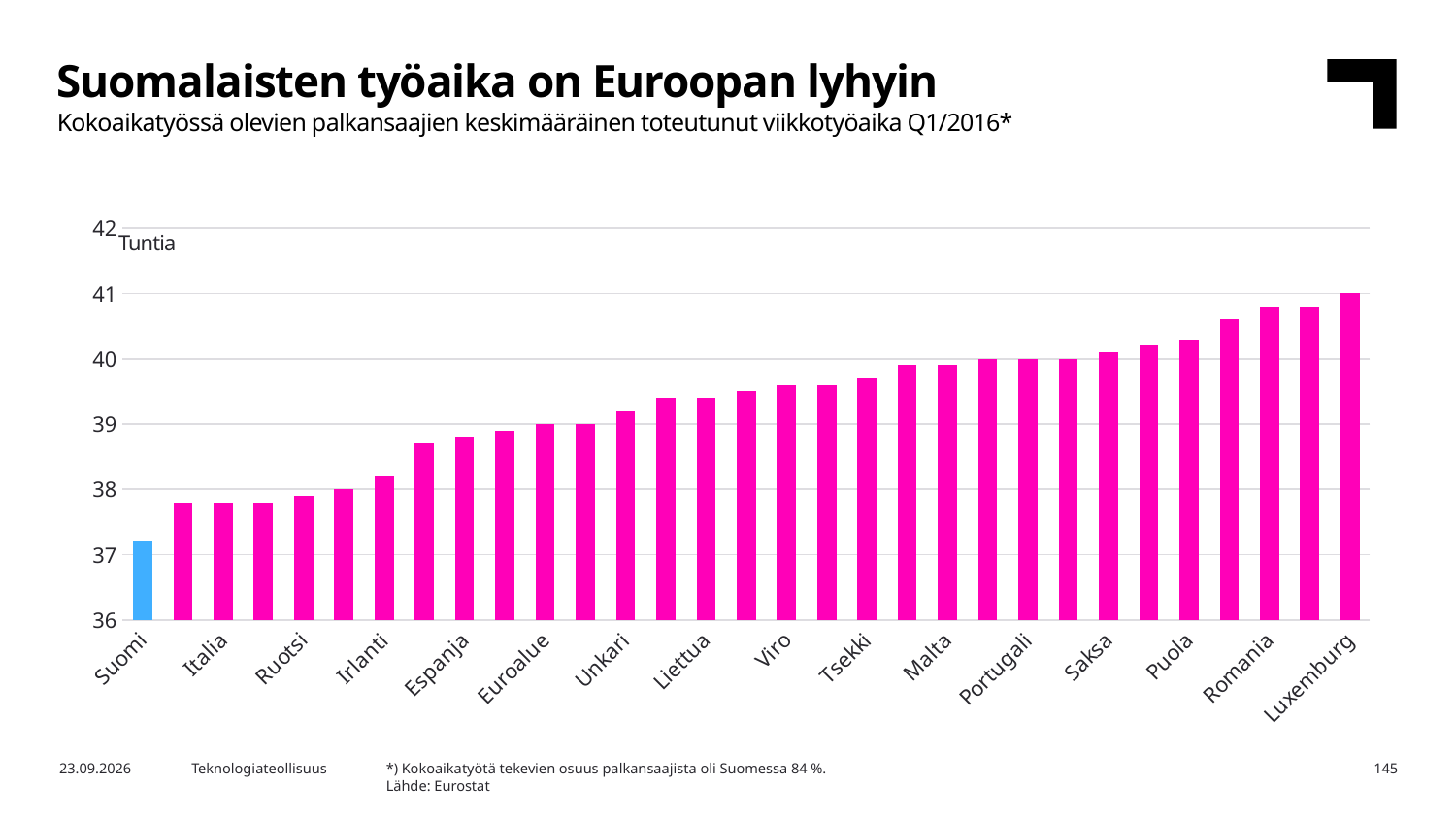
Is the value for Romania greater or less than 40? greater Is the value for Viro greater or less than 40? less Which country has the lowest average weekly working time in the chart? Suomi Is the value for Suomi greater or less than 38? less Which country has the highest average weekly working time in the chart? Luxemburg Which has a larger value, Italia or Romania? Romania What unit is shown at the top of the y axis? Tuntia Do the values rise or fall moving from left to right along the x axis? rise What kind of chart is shown on the slide? bar chart